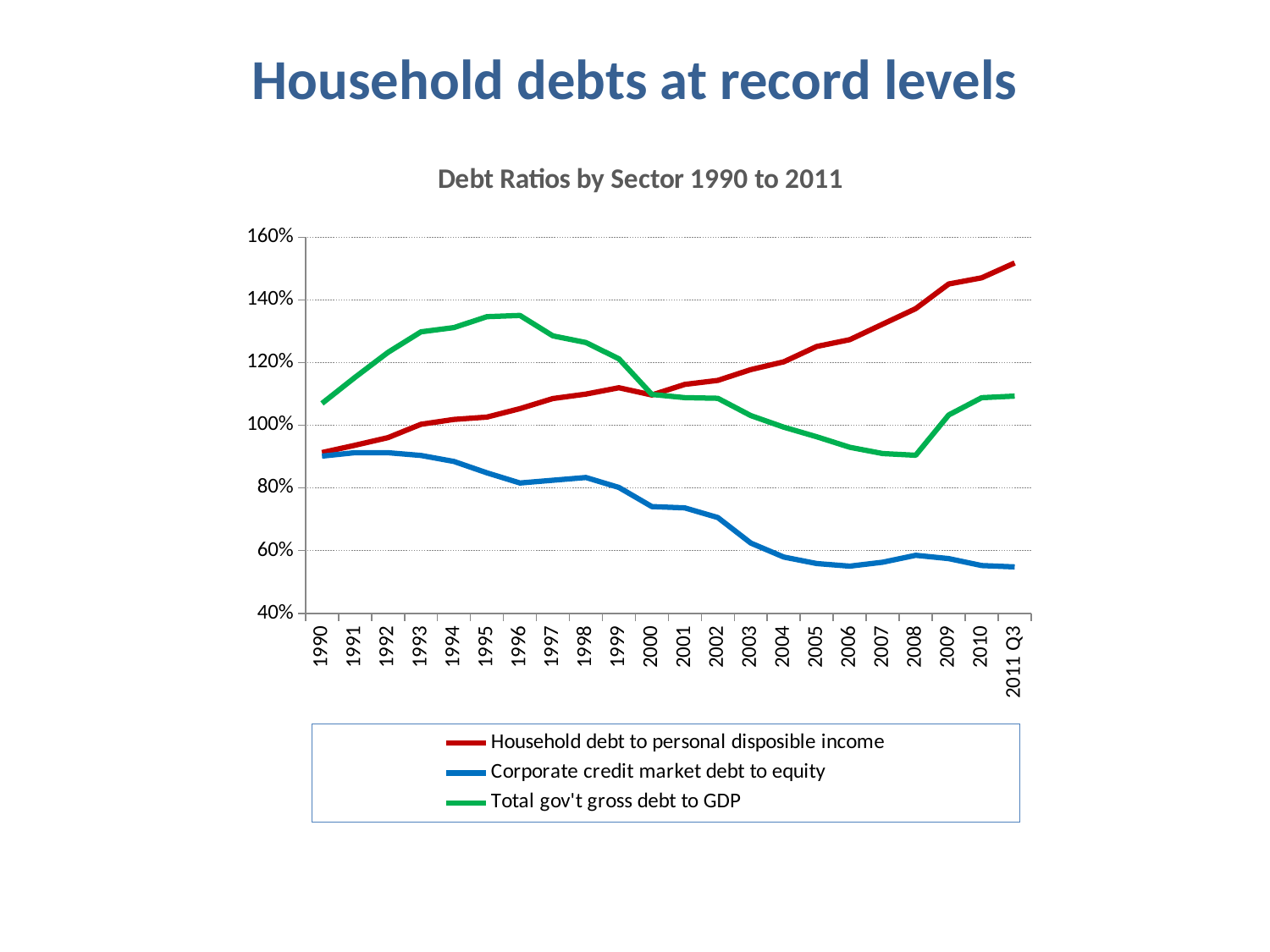
Is the value for Household debt to personal disposible income at 2011 Q3 greater or less than 140%? greater What is the title of the chart? Debt Ratios by Sector 1990 to 2011 Does the Household debt to personal disposible income series rise or fall from 1990 to 2011 Q3? rise How many points are on the x axis of the chart? 22 Is the value for Corporate credit market debt to equity in 2006 greater or less than 60%? less How many series does the legend list? 3 What kind of chart is shown on the slide? line chart Which series is drawn in green? Total gov't gross debt to GDP Which series has the lowest value in 2011 Q3? Corporate credit market debt to equity Which series has the highest value in 1995? Total gov't gross debt to GDP Is the value for Total gov't gross debt to GDP in 1996 greater or less than 120%? greater Does the Corporate credit market debt to equity series rise or fall from 1990 to 2011 Q3? fall